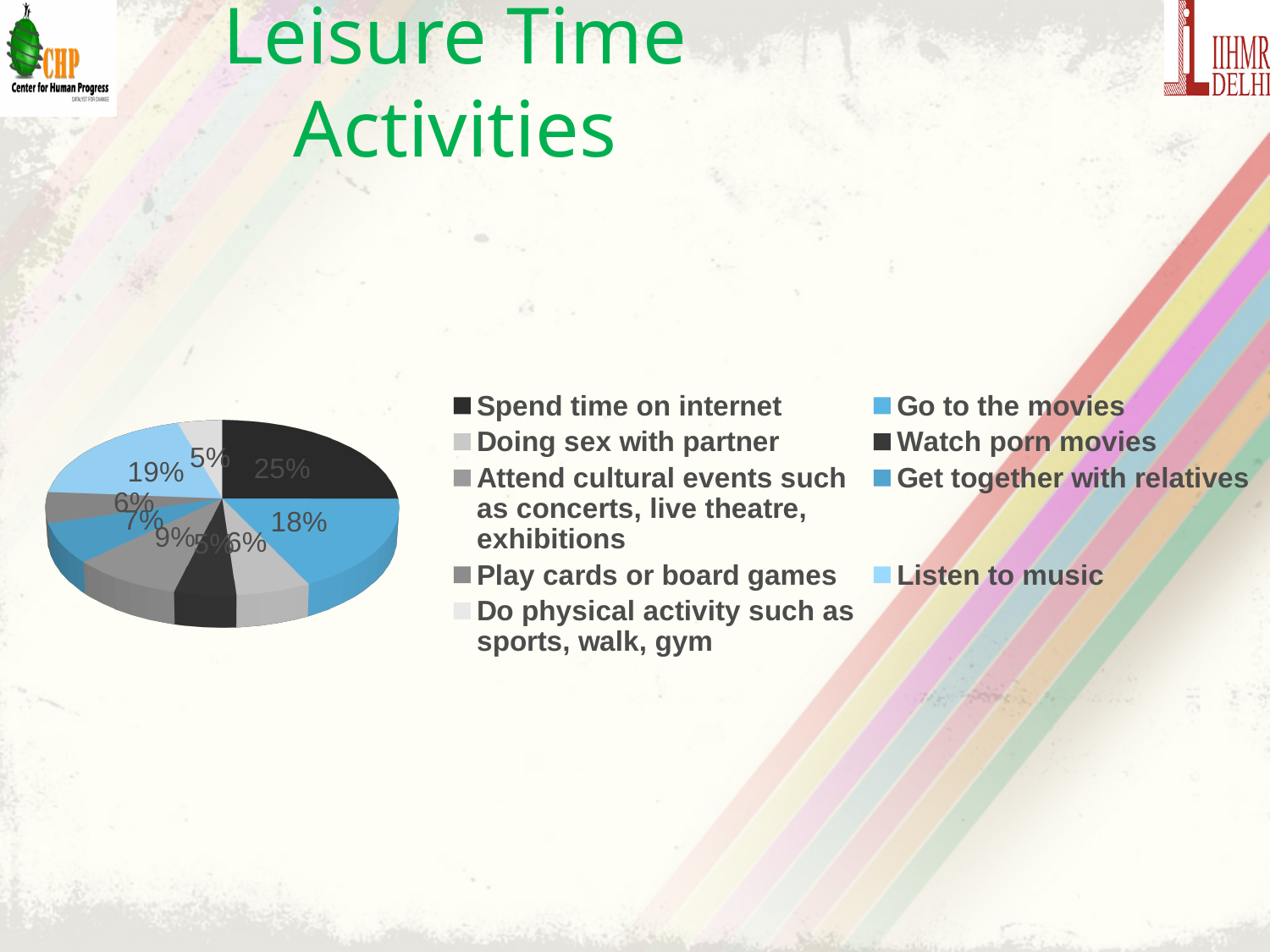
Which is larger on the pie chart: the 'Spend time on internet' slice or the 'Listen to music' slice? Spend time on internet What is the difference between the largest slice (25%) and the 18% slice of the pie chart? 7% What is the smallest percentage shown on the pie chart? 5% Which legend entry of the pie chart is shown in black and corresponds to the 25% slice? Spend time on internet What share of the pie chart is labelled for 'Listen to music'? 19% What is the largest percentage shown on the pie chart? 25% What share of the pie chart is labelled for 'Spend time on internet'? 25% What kind of chart is shown on the slide? pie chart How many leisure activities does the legend of the pie chart list? 9 What is the title of the slide containing the pie chart? Leisure Time Activities How many slices of the pie chart are labelled 5%? 2